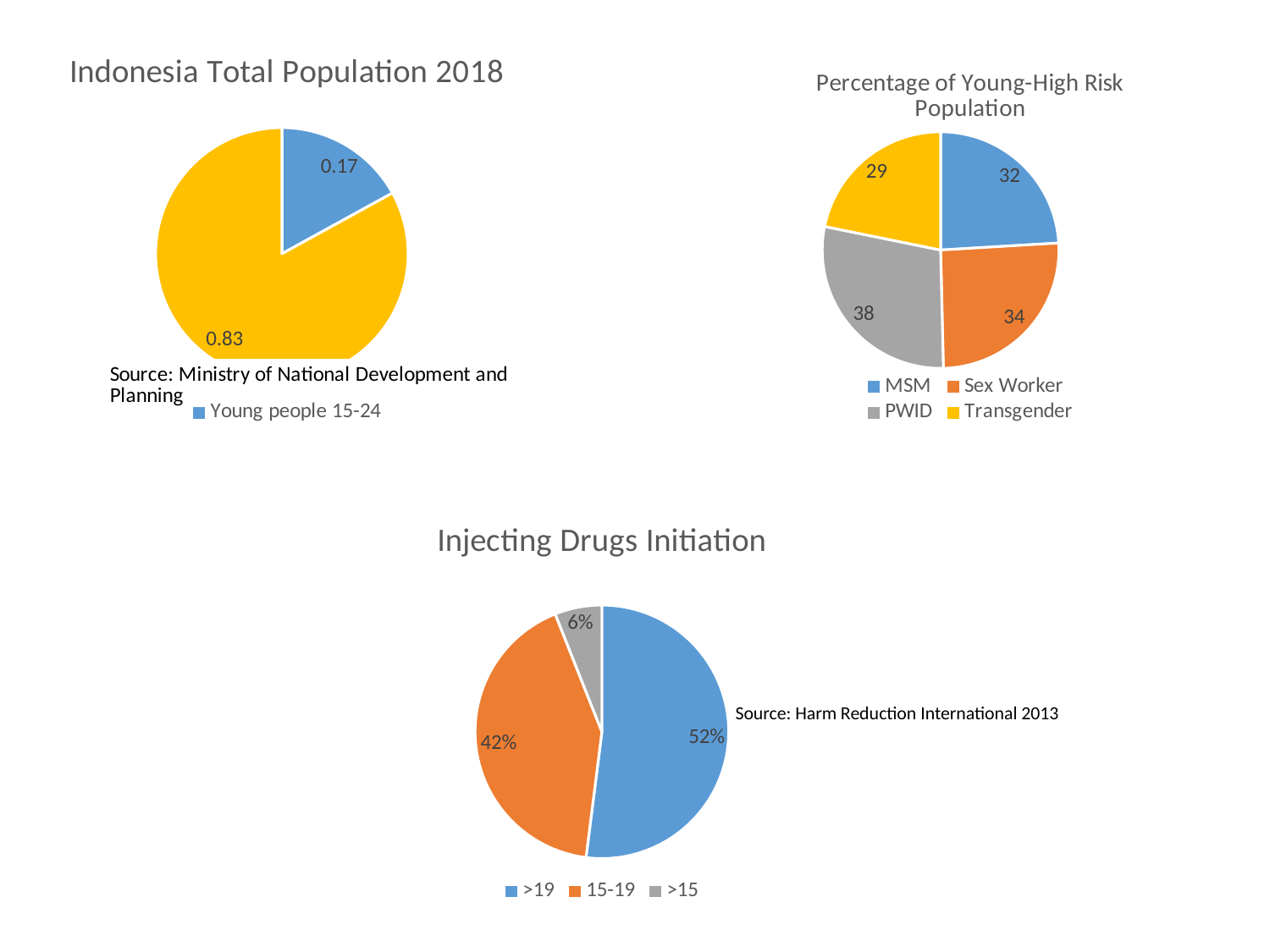
In the 'Percentage of Young-High Risk Population' chart, what is the value for PWID? 38 In the 'Percentage of Young-High Risk Population' chart, which group has the highest value? PWID In the 'Injecting Drugs Initiation' chart, which group has the smallest share? >15 What kind of chart is 'Indonesia Total Population 2018'? Pie chart How many groups are listed in the legend of the 'Percentage of Young-High Risk Population' chart? 4 In the 'Injecting Drugs Initiation' chart, which group has the largest share? >19 In the 'Indonesia Total Population 2018' chart, what is the value shown for Young people 15-24? 0.17 In the 'Percentage of Young-High Risk Population' chart, what is the difference between the PWID and Transgender values? 9 In the 'Injecting Drugs Initiation' chart, what percentage is shown for the 15-19 group? 42% In the 'Percentage of Young-High Risk Population' chart, which group has the lowest value? Transgender In the 'Percentage of Young-High Risk Population' chart, which is larger, Sex Worker or MSM? Sex Worker What source is cited for the 'Injecting Drugs Initiation' chart? Harm Reduction International 2013